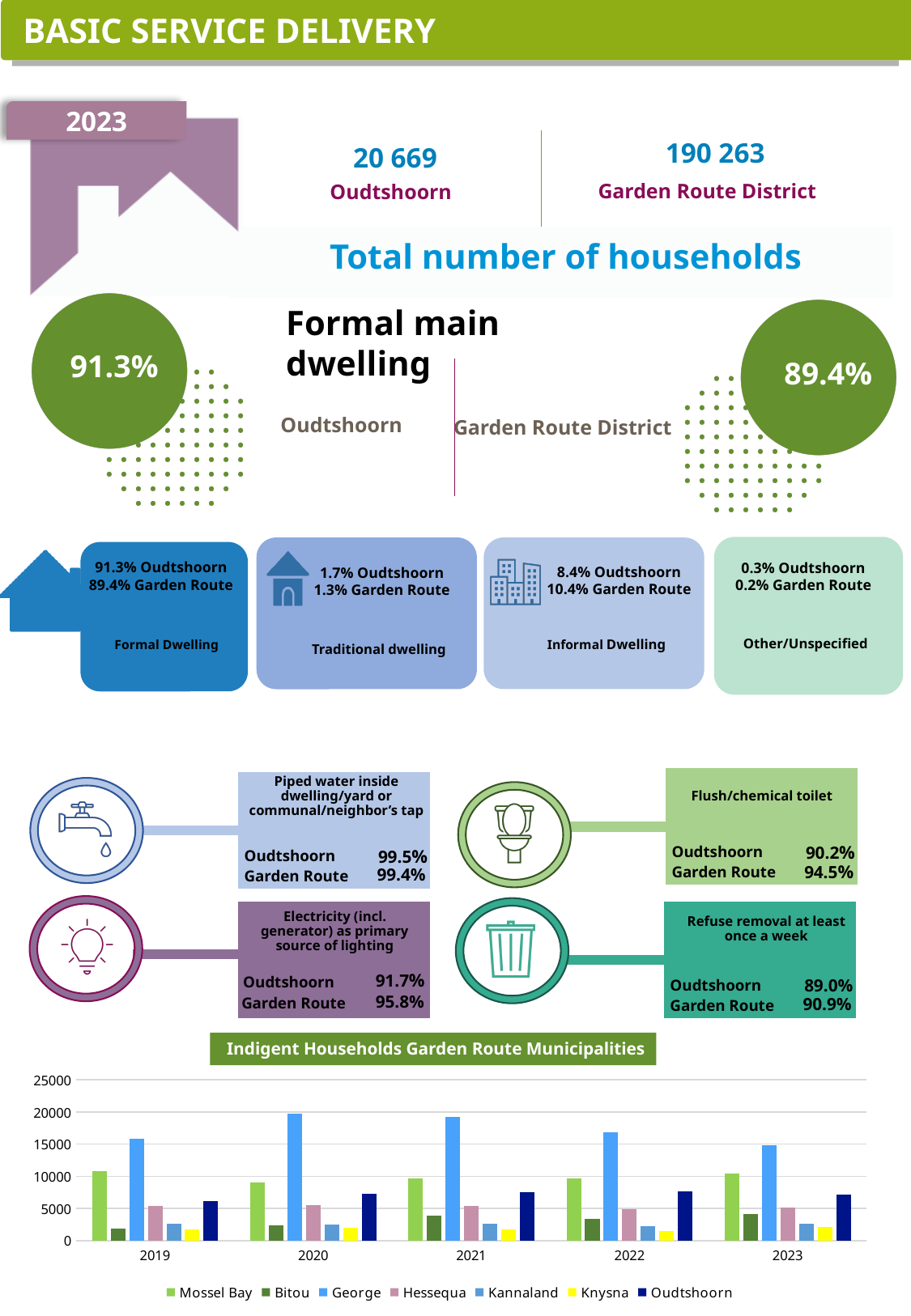
In the 'Indigent Households Garden Route Municipalities' chart, which municipality has the lowest value in 2019? Knysna How many years are shown on the x axis of the 'Indigent Households Garden Route Municipalities' chart? 5 What colour represents Knysna in the 'Indigent Households Garden Route Municipalities' chart? yellow In the 'Indigent Households Garden Route Municipalities' chart, is the value for Oudtshoorn in 2021 greater or less than 5000? greater How many municipalities does the legend of the 'Indigent Households Garden Route Municipalities' chart list? 7 In the 'Indigent Households Garden Route Municipalities' chart, is the value for Knysna in 2022 greater or less than 5000? less What kind of chart is the 'Indigent Households Garden Route Municipalities' chart? bar chart In the 'Indigent Households Garden Route Municipalities' chart, do the values for George rise or fall from 2020 to 2023? fall In the 'Indigent Households Garden Route Municipalities' chart, which municipality has the highest value in 2020? George In the 'Indigent Households Garden Route Municipalities' chart, is the value for George in 2020 greater or less than 15000? greater In the 'Indigent Households Garden Route Municipalities' chart, which is larger in 2023: Mossel Bay or Oudtshoorn? Mossel Bay In the 'Indigent Households Garden Route Municipalities' chart, which is larger in 2019: Bitou or Kannaland? Kannaland